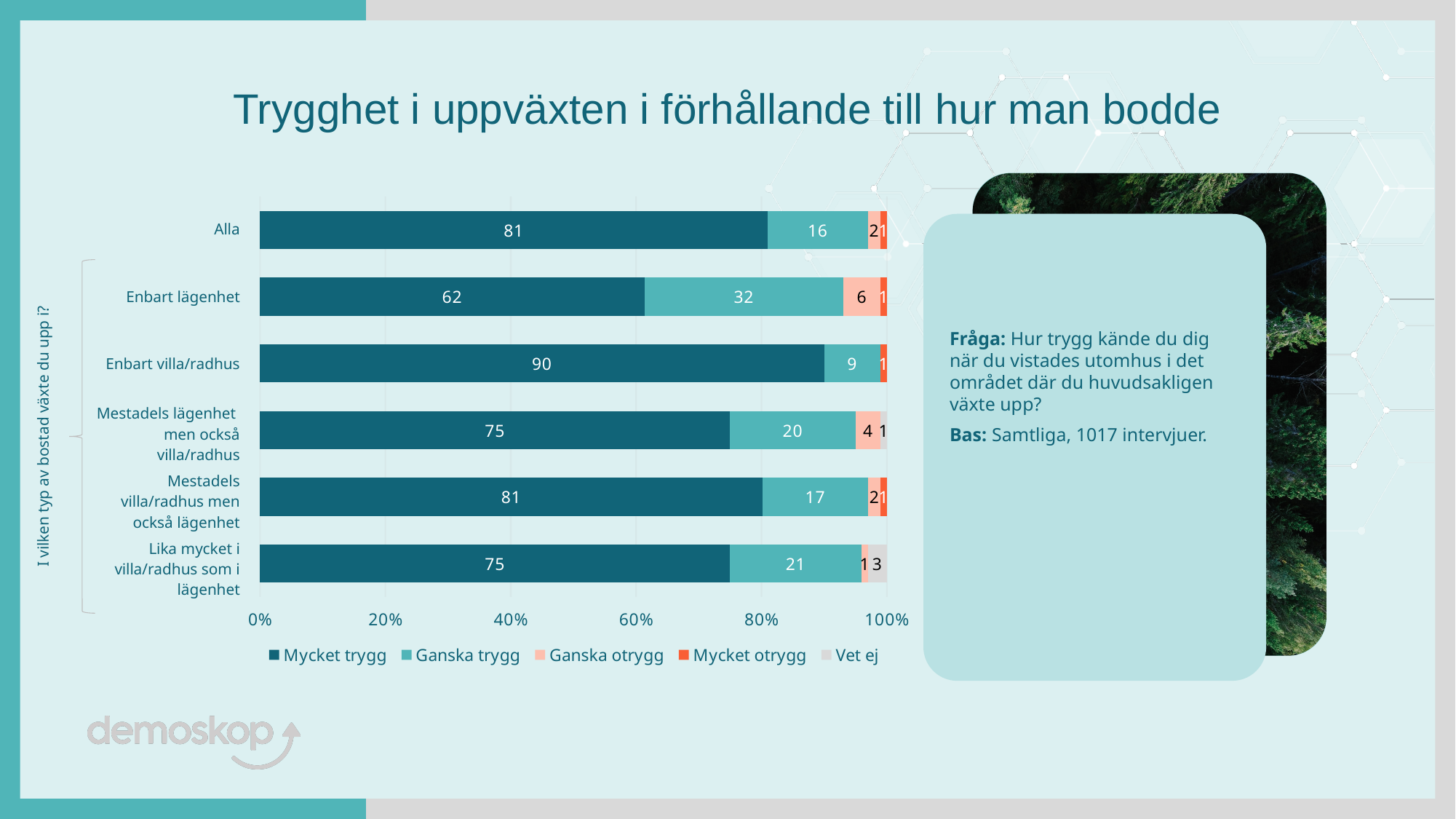
What is the difference between the Mycket trygg values for Enbart villa/radhus and Enbart lägenhet? 28 What is the value of Mycket trygg for Enbart villa/radhus? 90 Which category has the lowest Mycket trygg value? Enbart lägenhet What is the value of Mycket trygg for Enbart lägenhet? 62 Which category has the highest Mycket trygg value? Enbart villa/radhus What is the value of Ganska trygg for Enbart lägenhet? 32 What kind of chart is shown on the slide? Stacked bar chart What is the value of Ganska trygg for Alla? 16 How many series does the legend list? 5 What is the value of Ganska otrygg for Mestadels lägenhet men också villa/radhus? 4 Which is larger: the Ganska trygg value for Enbart lägenhet or for Lika mycket i villa/radhus som i lägenhet? Enbart lägenhet How many categories are shown on the chart? 6